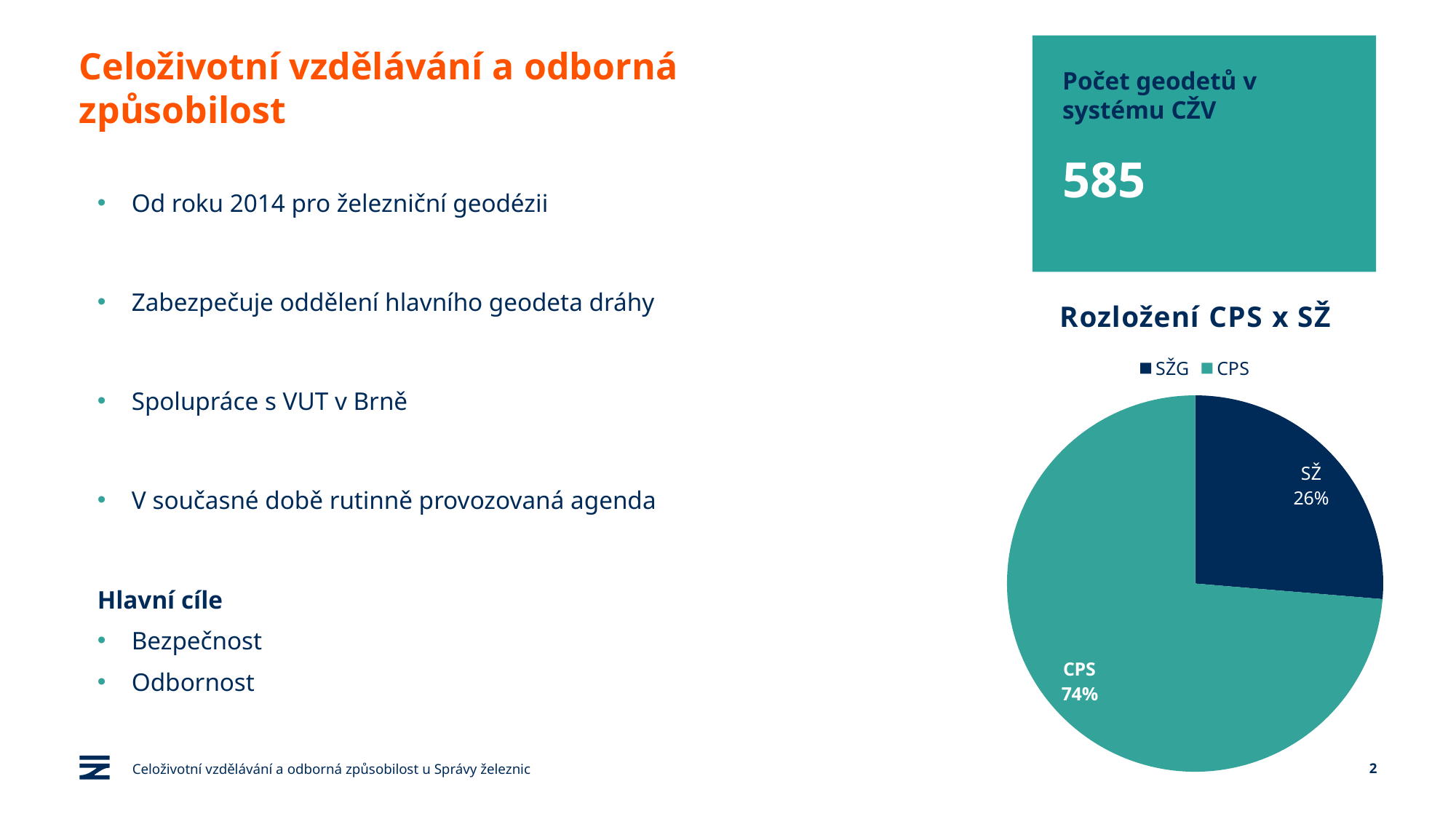
Which legend entry of the pie chart is shown in dark navy blue? SŽG What kind of chart is shown under the title "Rozložení CPS x SŽ"? pie chart Which slice of the pie chart is the smallest? SŽ In the pie chart, which is larger, the CPS slice or the SŽ slice? CPS How many slices does the pie chart have? 2 In the pie chart, what share is labelled for the SŽ slice? 26% How many entries does the legend of the pie chart list? 2 What is the difference in percentage points between the CPS slice and the SŽ slice in the pie chart? 48 In the pie chart, what share is labelled for the CPS slice? 74% What is the title of the pie chart on the slide? Rozložení CPS x SŽ Which slice of the pie chart is the largest? CPS